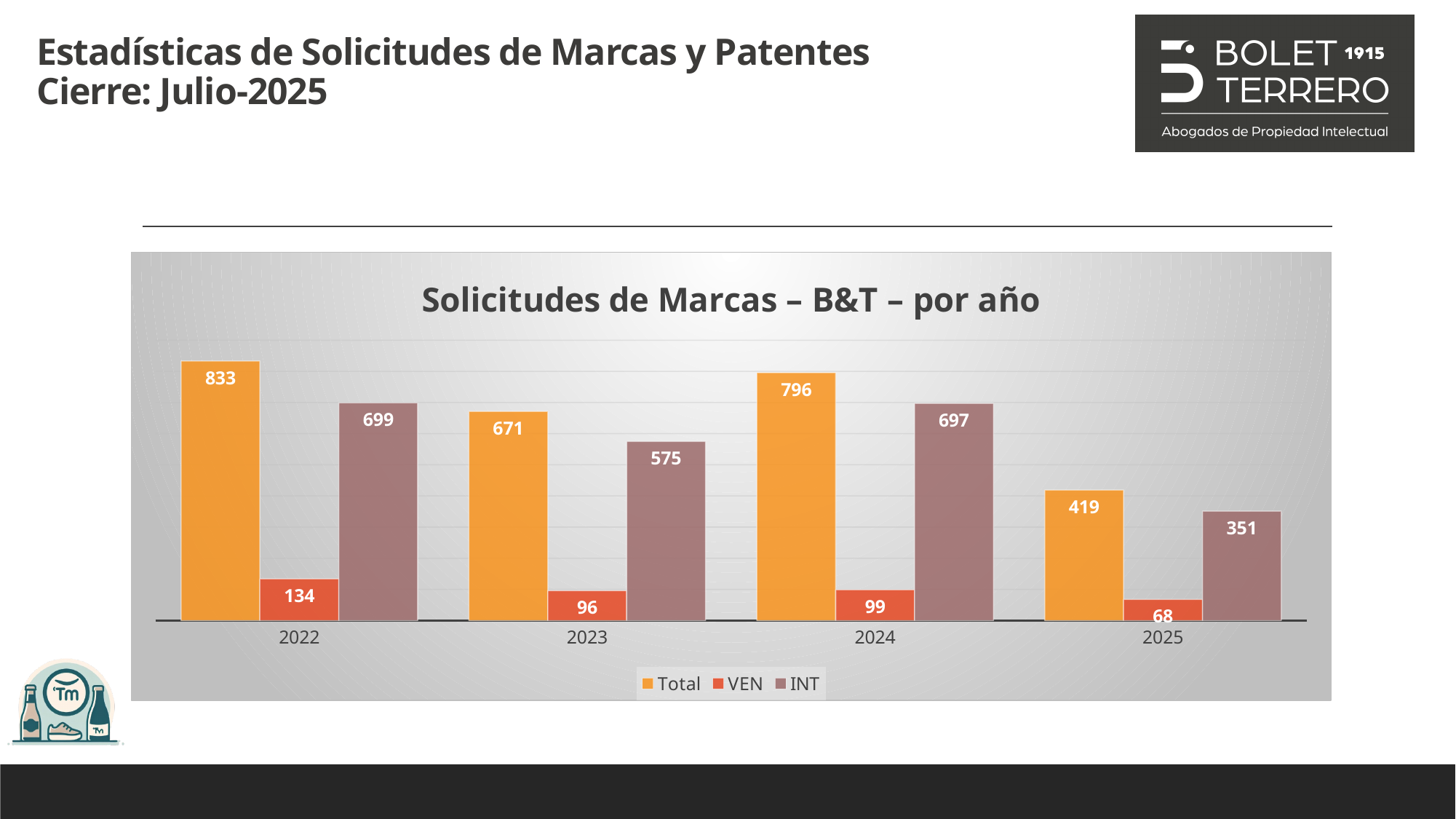
What is the title of the chart? Solicitudes de Marcas – B&T – por año How many series does the legend list? 3 What is the difference between the Total and INT values for 2024? 99 What is the VEN value for 2024? 99 What kind of chart is shown? Bar chart How many years are shown on the x axis? 4 Which year has the lowest VEN value? 2025 What is the difference between the INT values for 2022 and 2025? 348 What is the Total value for 2022? 833 Which is larger, the Total value for 2023 or the Total value for 2024? 2024 Which year has the highest Total value? 2022 What is the INT value for 2023? 575